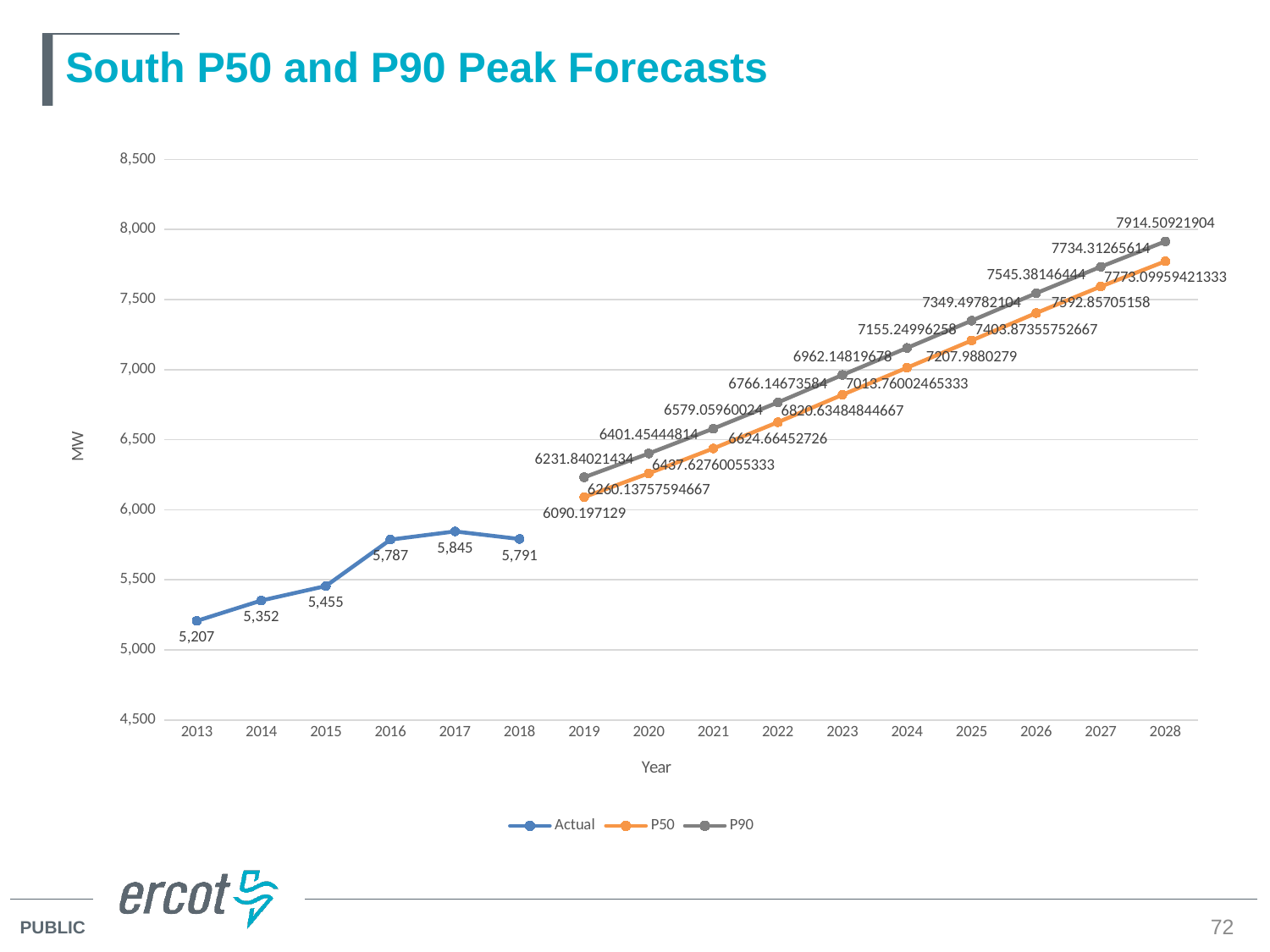
How many series does the legend list? 3 Which year has the lowest Actual value? 2013 What type of chart is shown on the slide? line chart What is the P90 value for 2028? 7914.50921904 What is the Actual value for 2013? 5,207 Which is larger in 2028, the P50 value or the P90 value? P90 What is the P50 value for 2019? 6090.197129 How many years are shown on the x axis? 16 Is the P50 value for 2024 greater or less than 7,000? greater What is the difference between the Actual values for 2017 and 2018? 54 What is the Actual value for 2017? 5,845 Which year has the highest Actual value? 2017